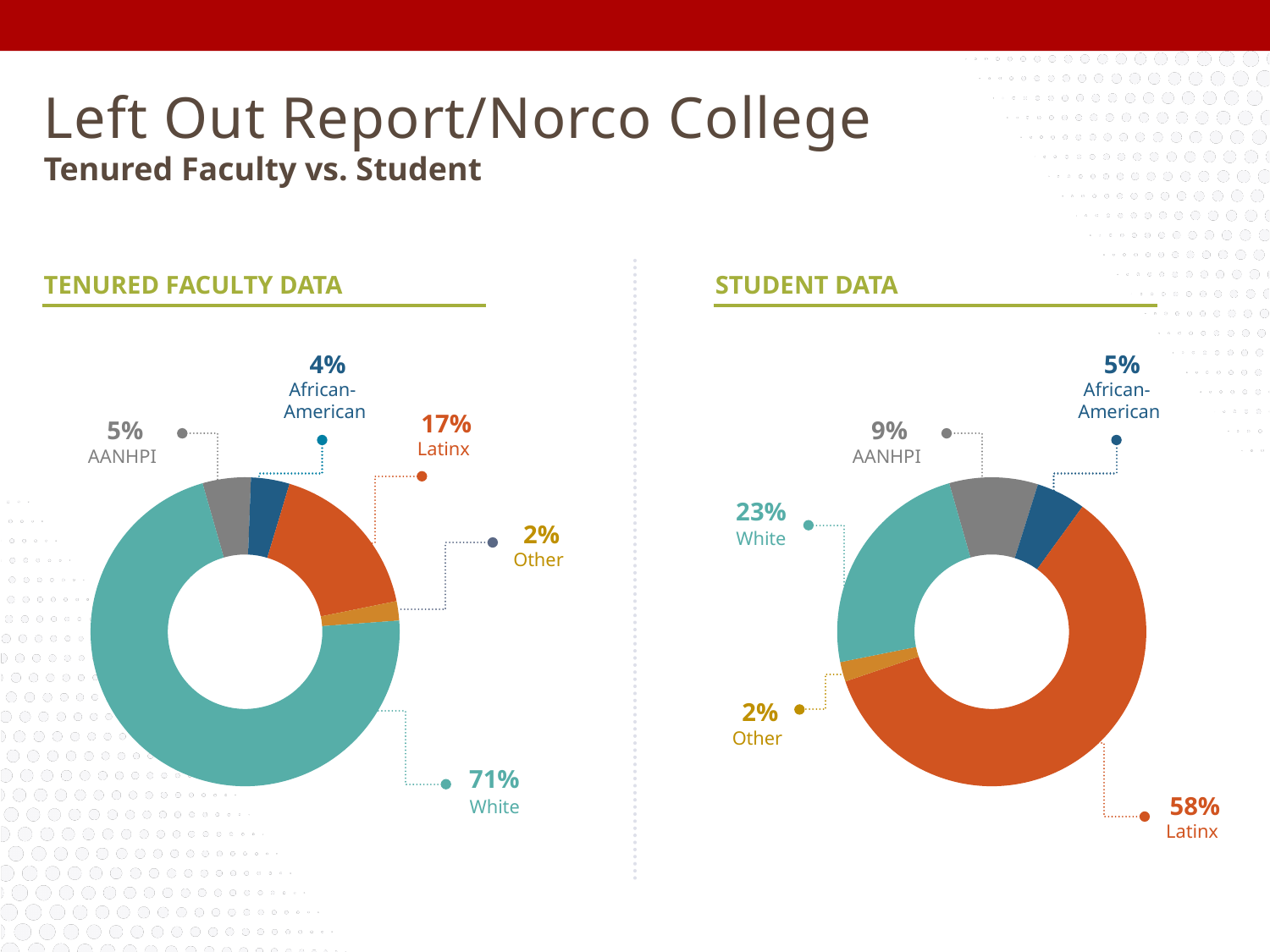
In the Student Data chart, which group has the largest share? Latinx What type of chart is used for the Tenured Faculty Data? Donut (pie) chart In the Student Data chart, what percentage is African-American? 5% In the Tenured Faculty Data chart, what percentage is White? 71% Which is larger: the White share in the Tenured Faculty Data chart or the White share in the Student Data chart? Tenured Faculty Data What is the difference between the Latinx share in the Student Data chart and the Latinx share in the Tenured Faculty Data chart? 41% How many groups are shown in the Student Data chart? 5 In the Tenured Faculty Data chart, what percentage is AANHPI? 5% In the Tenured Faculty Data chart, which group has the largest share? White In the Student Data chart, what percentage is Latinx? 58% In the Tenured Faculty Data chart, what is the difference between the White share and the Latinx share? 54% In the Student Data chart, which group has the smallest share? Other